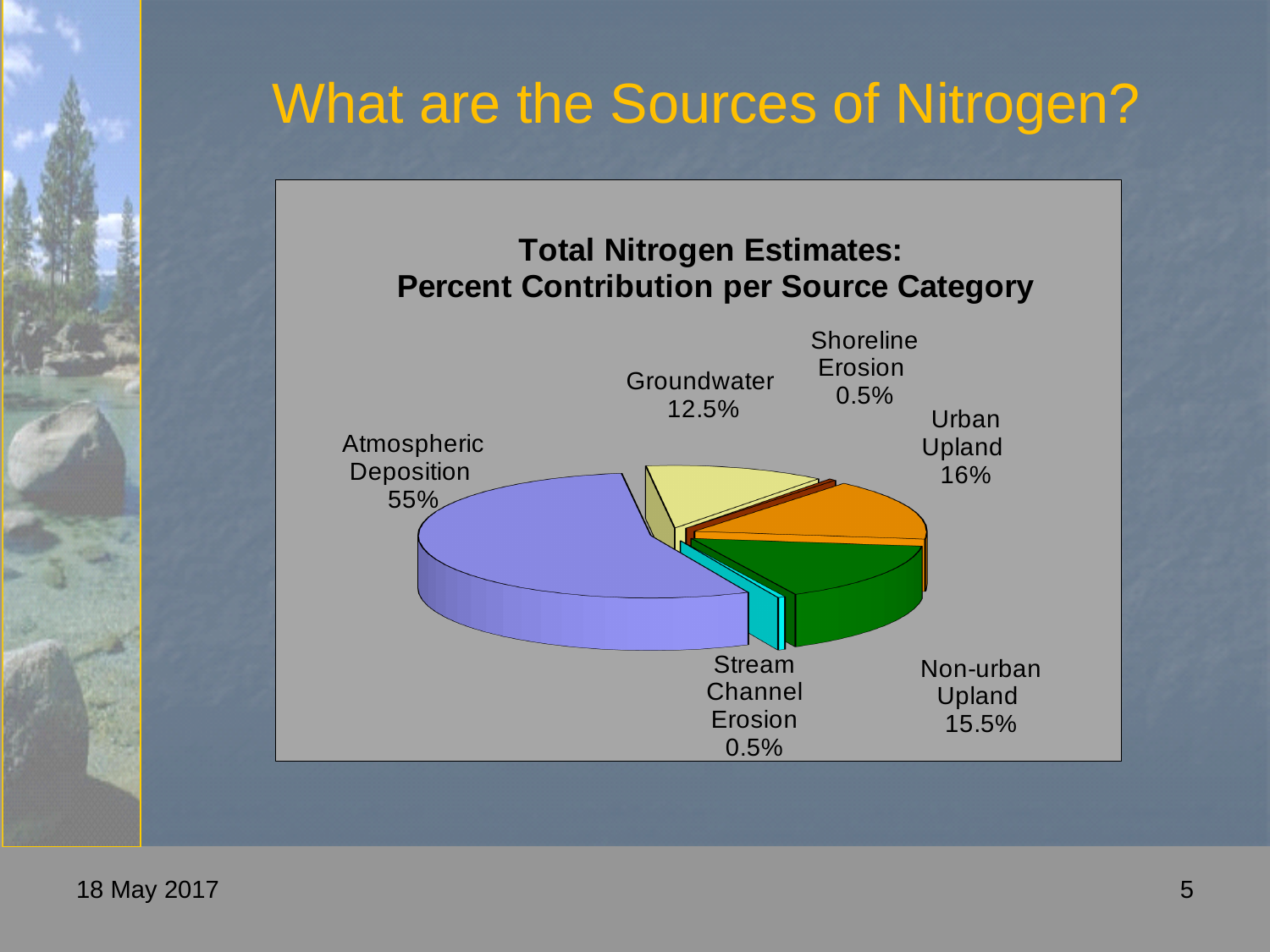
How many source categories are shown in the pie chart? 6 What is the percent contribution of Shoreline Erosion? 0.5% What is the difference in percent contribution between Urban Upland and Non-urban Upland? 0.5% What is the title of the chart? Total Nitrogen Estimates: Percent Contribution per Source Category What is the percent contribution of Groundwater? 12.5% What is the percent contribution of Non-urban Upland? 15.5% Which source category has the largest share of total nitrogen? Atmospheric Deposition Which contributes more to total nitrogen, Groundwater or Urban Upland? Urban Upland What kind of chart is shown on the slide? Pie chart What is the percent contribution of Urban Upland? 16% What is the difference in percent contribution between Atmospheric Deposition and Groundwater? 42.5% What is the percent contribution of Atmospheric Deposition? 55%